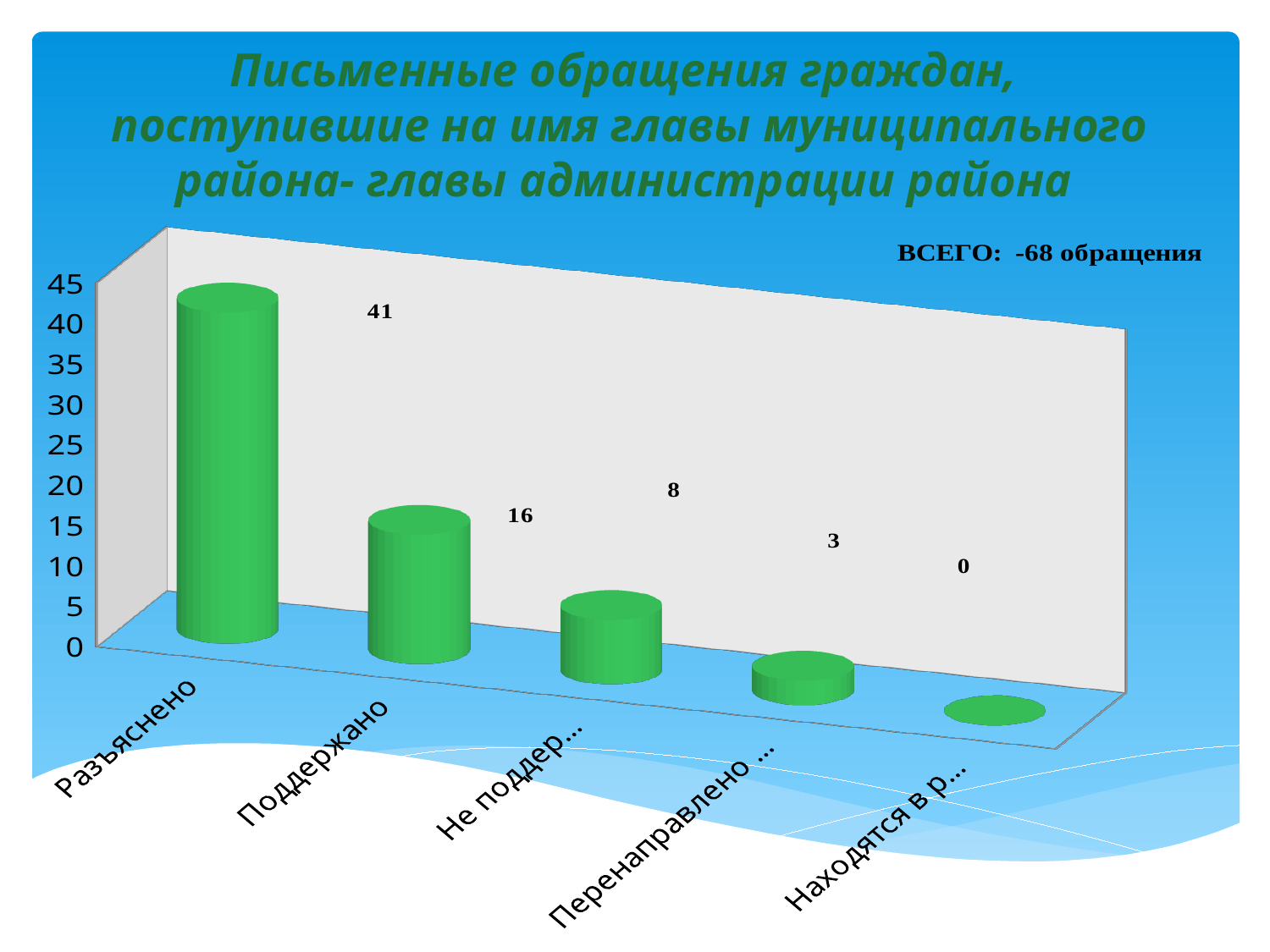
Do the values rise or fall from left to right along the x axis? Fall How many categories are shown on the chart? 5 What is the value of the third bar from the left? 8 Which is larger, the value for Поддержано or the value of the third bar? Поддержано What is the value for Поддержано? 16 What kind of chart is shown on the slide? Bar chart What total number of appeals (ВСЕГО) is stated on the chart? 68 обращения What is the value of the fourth bar from the left? 3 What is the value of the last (rightmost) category? 0 Which category has the highest value? Разъяснено What is the difference between the values for Разъяснено and Поддержано? 25 What is the value for Разъяснено? 41